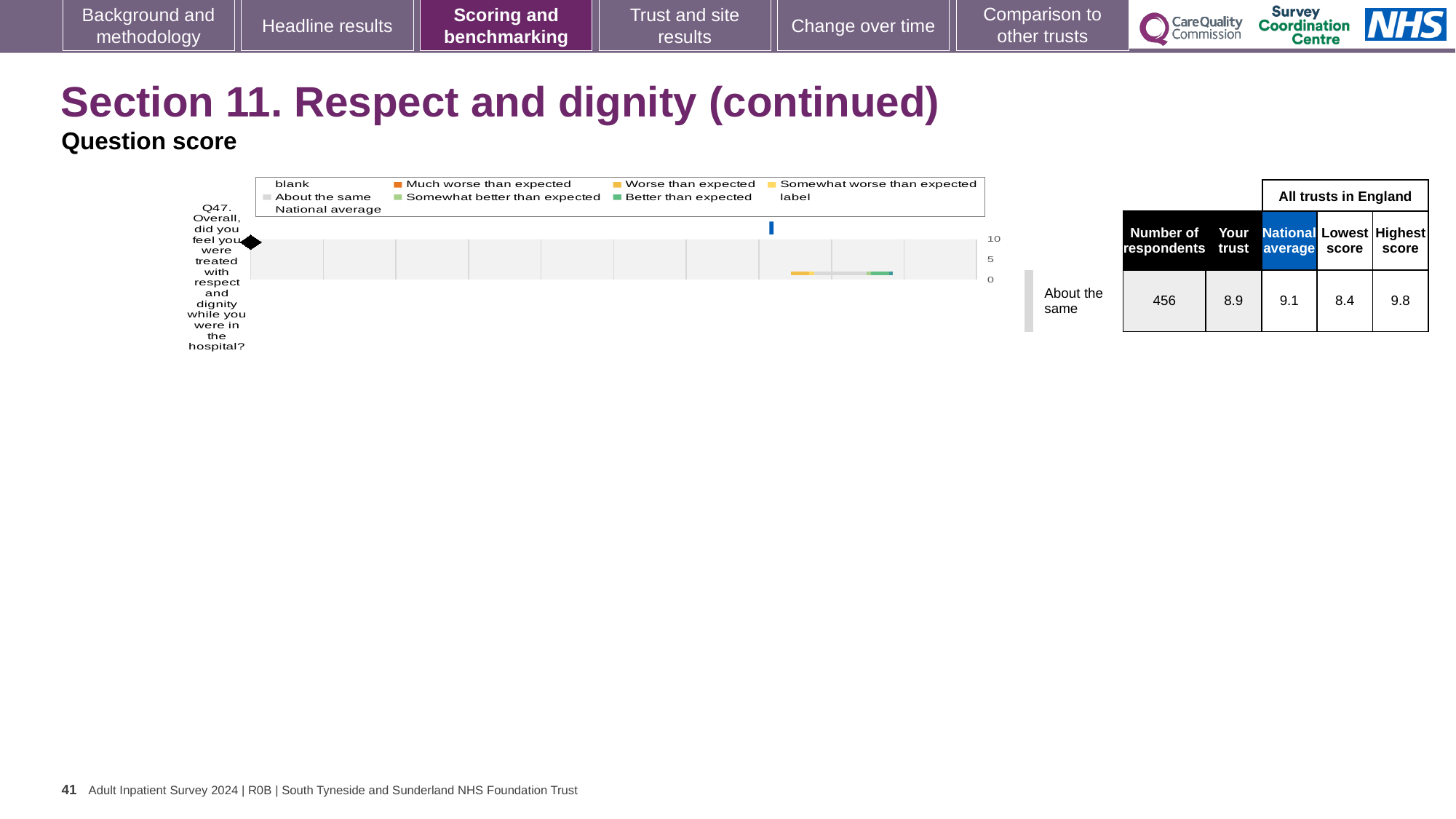
Which is larger for Q47, the trust's score or the national average? National average What is the lowest score among all trusts in England for Q47? 8.4 How many respondents answered Q47? 456 How many questions are plotted on the chart? 1 What is the national average score for Q47? 9.1 What is the highest score among all trusts in England for Q47? 9.8 What type of chart is used to show the Q47 question score? bar chart Which benchmark category is the trust's Q47 result placed in? About the same What is the 'Your trust' score for Q47? 8.9 How many entries does the chart legend list? 9 Which question number is plotted on the chart? Q47 What is the difference between the highest and lowest scores for Q47? 1.4